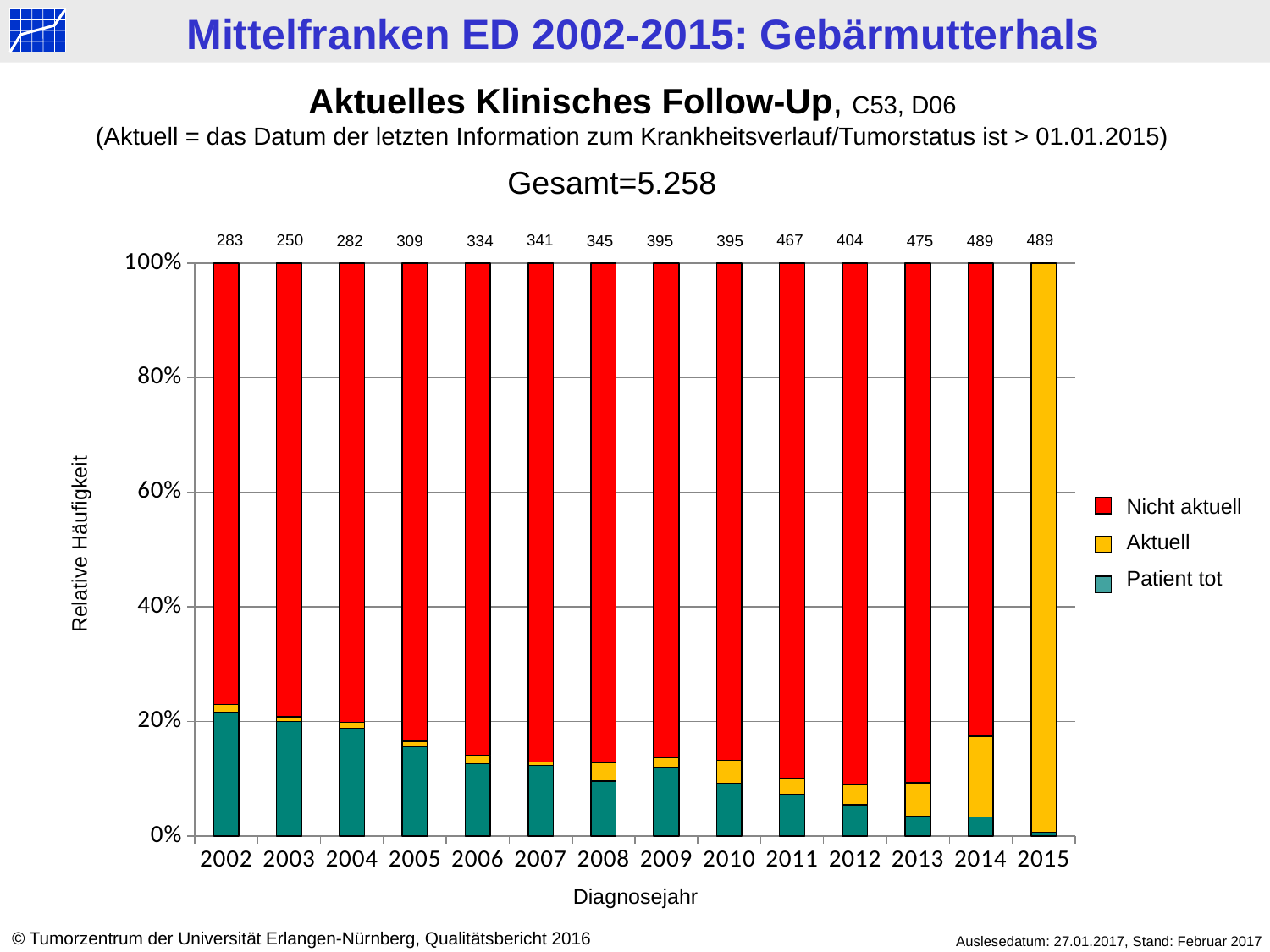
Which year has the larger number printed above its bar, 2011 or 2012? 2011 What is the number printed above the bar for 2003? 250 What total (Gesamt) is stated above the chart? 5.258 What is the number printed above the bar for 2011? 467 How many series does the legend list? 3 Is the 'Patient tot' share for 2005 greater or less than 20%? less Is the 'Aktuell' share for 2015 greater or less than 80%? greater How many diagnosis years are shown on the x axis? 14 Does the 'Patient tot' share rise or fall from 2002 to 2015? fall What kind of chart is shown on the slide? bar chart What is the difference between the numbers printed above the bars for 2011 and 2003? 217 Which diagnosis year has the lowest number printed above its bar? 2003